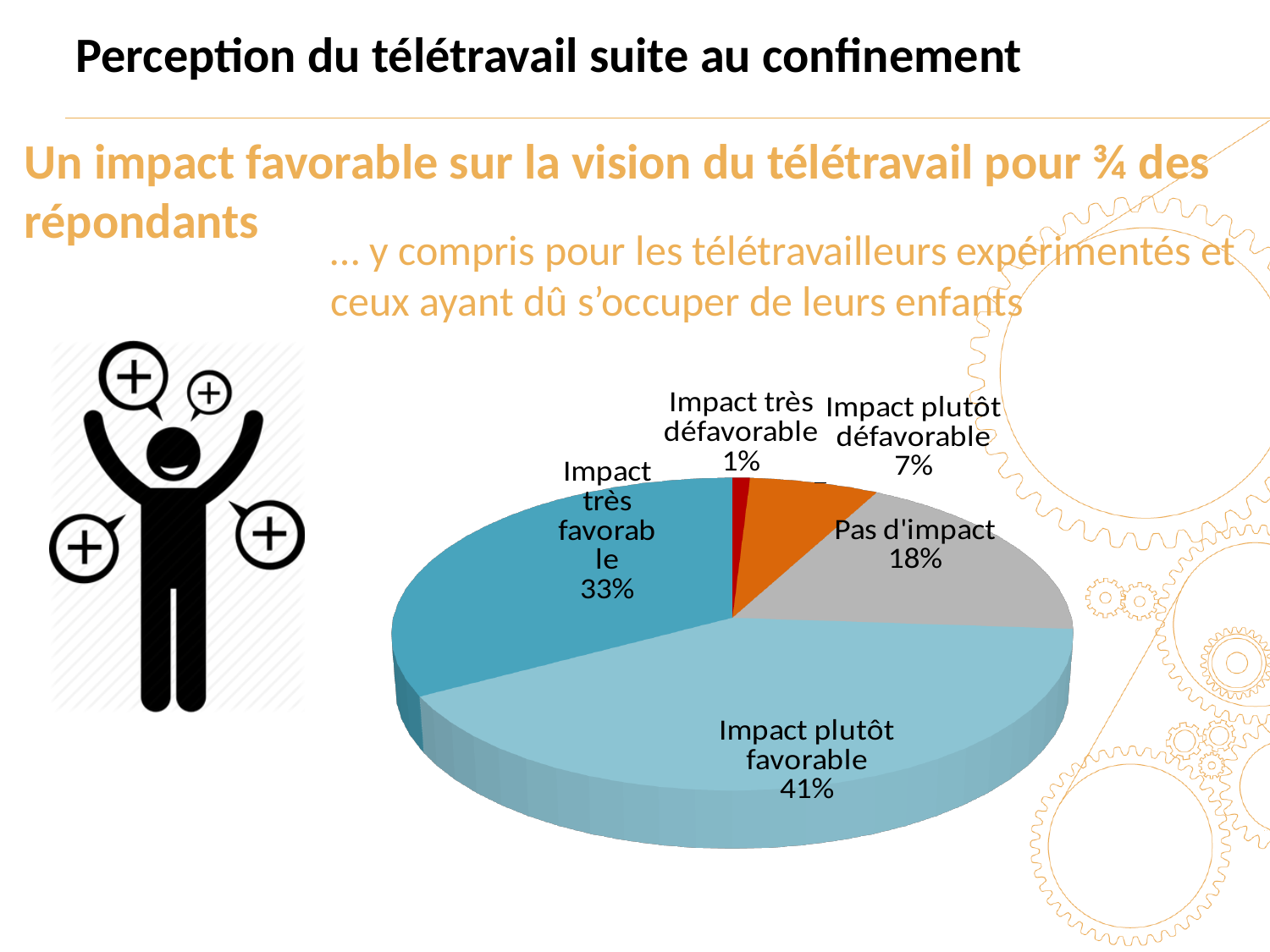
What share of respondents reported 'Pas d'impact'? 18% Which category has the smallest slice of the pie? Impact très défavorable What kind of chart is shown on the slide? pie chart What is the combined share of 'Impact plutôt favorable' and 'Impact très favorable'? 74% What is the difference in percentage points between 'Impact plutôt favorable' and 'Impact très favorable'? 8 What share of respondents reported 'Impact plutôt favorable'? 41% Which category has the largest slice of the pie? Impact plutôt favorable How many categories are shown in the pie chart? 5 What share of respondents reported 'Impact très défavorable'? 1% Which is larger: the share for 'Pas d'impact' or the share for 'Impact plutôt défavorable'? Pas d'impact What share of respondents reported 'Impact très favorable'? 33% What share of respondents reported 'Impact plutôt défavorable'? 7%